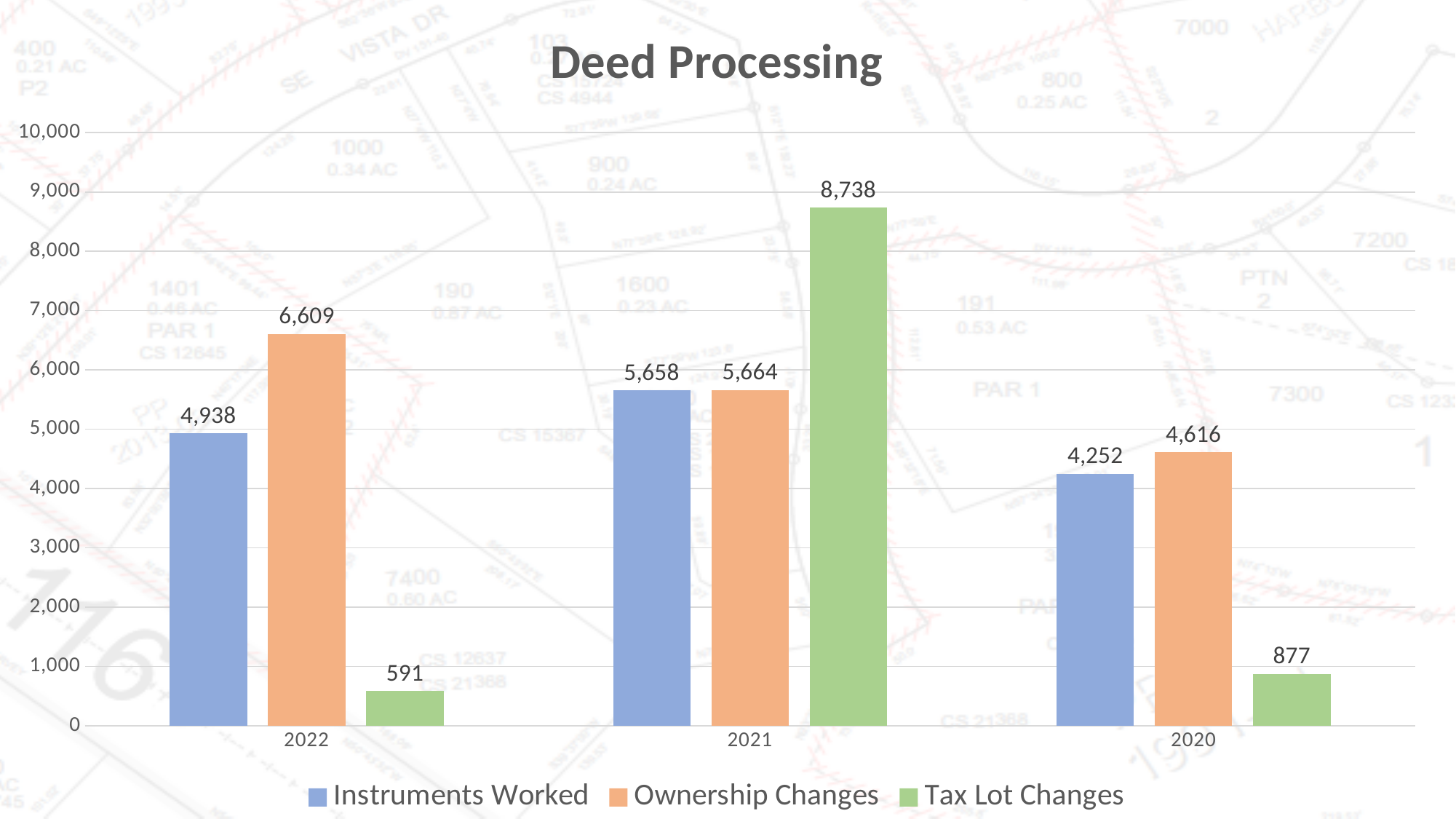
What is the difference between Ownership Changes in 2022 and Ownership Changes in 2020? 1,993 How many years are shown on the x axis? 3 What is the value for Instruments Worked in 2022? 4,938 What is the title of the chart? Deed Processing What kind of chart is shown on the slide? bar chart Which year has the highest value for Tax Lot Changes? 2021 Which is larger: Tax Lot Changes in 2020 or Tax Lot Changes in 2022? Tax Lot Changes in 2020 Is the value for Ownership Changes in 2022 greater or less than 6,000? greater What is the value for Tax Lot Changes in 2021? 8,738 What is the value for Ownership Changes in 2020? 4,616 Which year has the lowest value for Instruments Worked? 2020 How many series does the legend list? 3